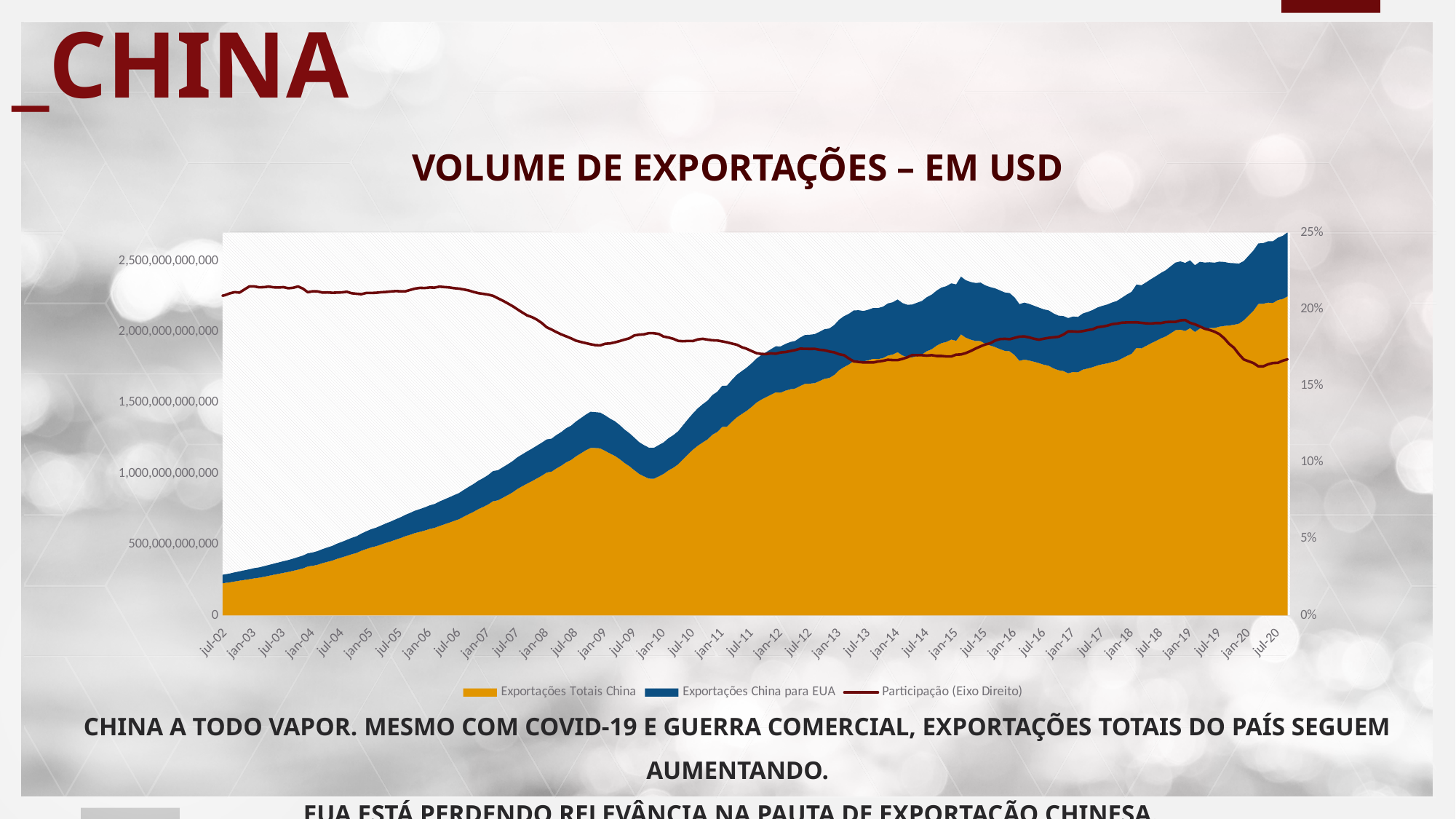
What kind of chart is shown on the slide? Stacked area chart with a line Is the value of Participação (Eixo Direito) at jul-20 greater or less than 20%? less Is the value of Participação (Eixo Direito) at jan-16 greater or less than 20%? less Does the Participação (Eixo Direito) line generally rise or fall from jul-02 to jul-20? Fall What is the title of the chart? VOLUME DE EXPORTAÇÕES – EM USD Which series is plotted on the right-hand axis? Participação (Eixo Direito) Does the Exportações Totais China series generally rise or fall from jul-02 to jul-20? Rise Is the value of Exportações Totais China at jul-20 greater or less than 2,000,000,000,000? greater How many series does the legend list? 3